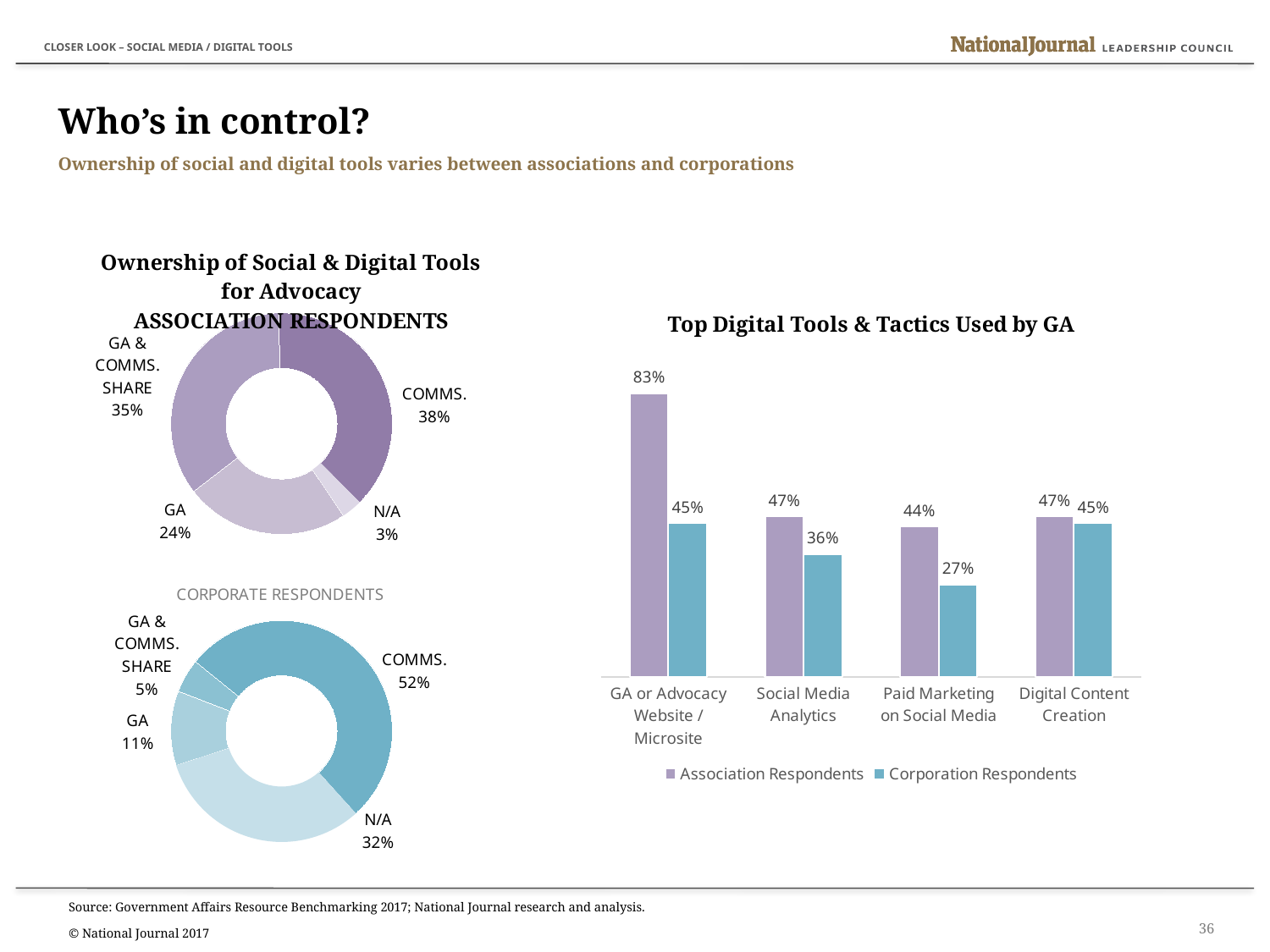
Which is larger: the GA share in the Association Respondents chart or the GA share in the Corporate Respondents chart? Association Respondents In the 'Top Digital Tools & Tactics Used by GA' chart, what is the value for Corporation Respondents for Paid Marketing on Social Media? 27% What kind of chart is 'Top Digital Tools & Tactics Used by GA'? Bar chart In the Corporate Respondents donut chart, what share is N/A? 32% In the 'Top Digital Tools & Tactics Used by GA' chart, which category has the highest value for Association Respondents? GA or Advocacy Website / Microsite In the 'Top Digital Tools & Tactics Used by GA' chart, what is the value for Association Respondents for GA or Advocacy Website / Microsite? 83% In the Corporate Respondents donut chart, which category has the smallest share? GA & COMMS. SHARE In the 'Top Digital Tools & Tactics Used by GA' chart, how many categories are shown on the x axis? 4 In the 'Top Digital Tools & Tactics Used by GA' chart, how many series does the legend list? 2 In the 'Top Digital Tools & Tactics Used by GA' chart, what is the difference between Association Respondents and Corporation Respondents for GA or Advocacy Website / Microsite? 38% In the 'Top Digital Tools & Tactics Used by GA' chart, which category has the lowest value for Corporation Respondents? Paid Marketing on Social Media In the Association Respondents donut chart, what share is COMMS.? 38%